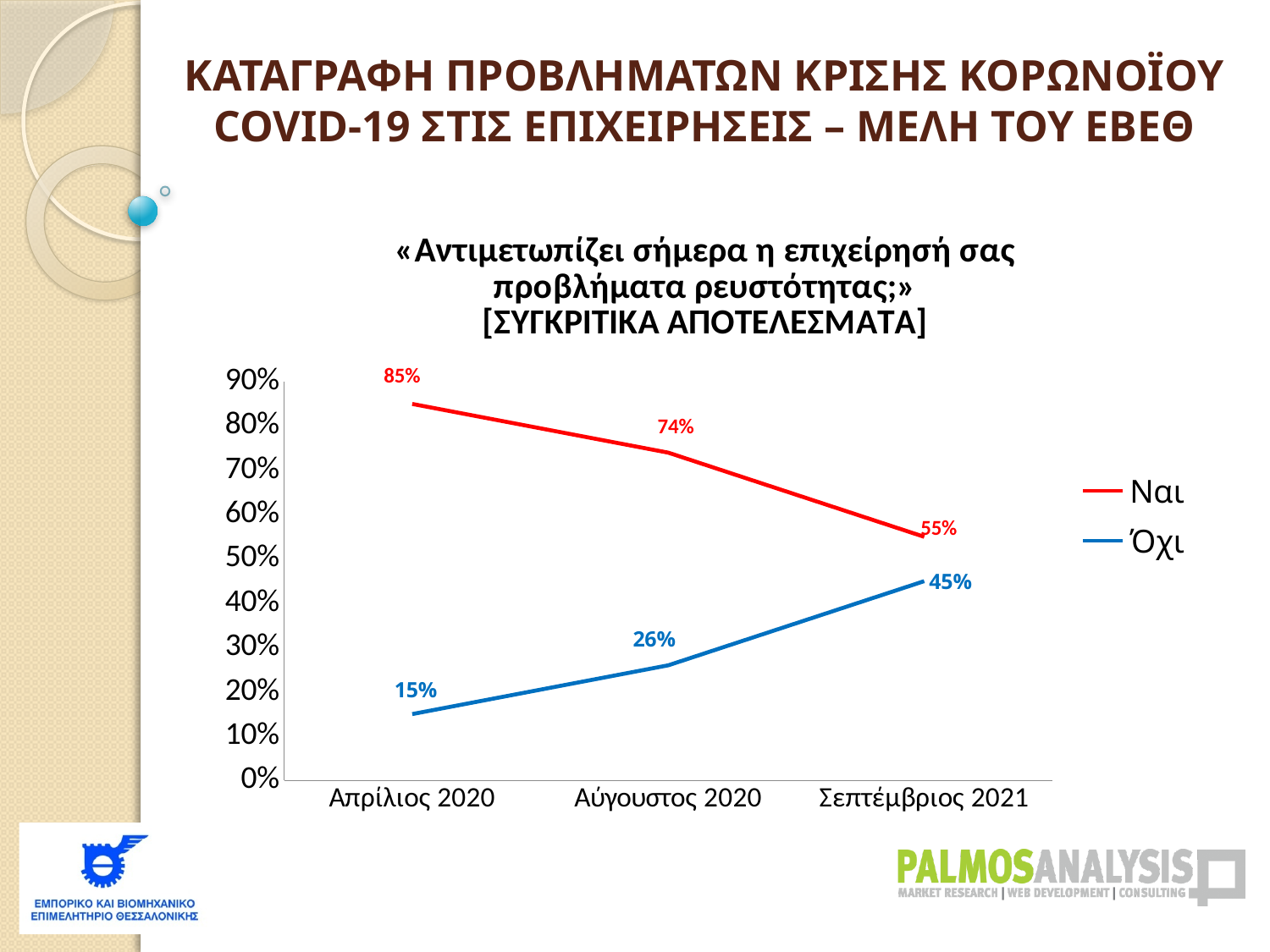
What is the value for Όχι in Αύγουστος 2020? 26% What is the value for Ναι in Απρίλιος 2020? 85% By how much did the Ναι series fall from Απρίλιος 2020 to Σεπτέμβριος 2021? 30% In which period is the Όχι series highest? Σεπτέμβριος 2021 Does the Όχι series rise or fall from Απρίλιος 2020 to Σεπτέμβριος 2021? rise In which period is the Ναι series lowest? Σεπτέμβριος 2021 Which is larger in Σεπτέμβριος 2021, Ναι or Όχι? Ναι What is the difference between Ναι and Όχι in Αύγουστος 2020? 48% How many series does the legend list? 2 How many time periods are shown on the x axis? 3 What type of chart is shown on the slide? line chart What is the value for Όχι in Σεπτέμβριος 2021? 45%